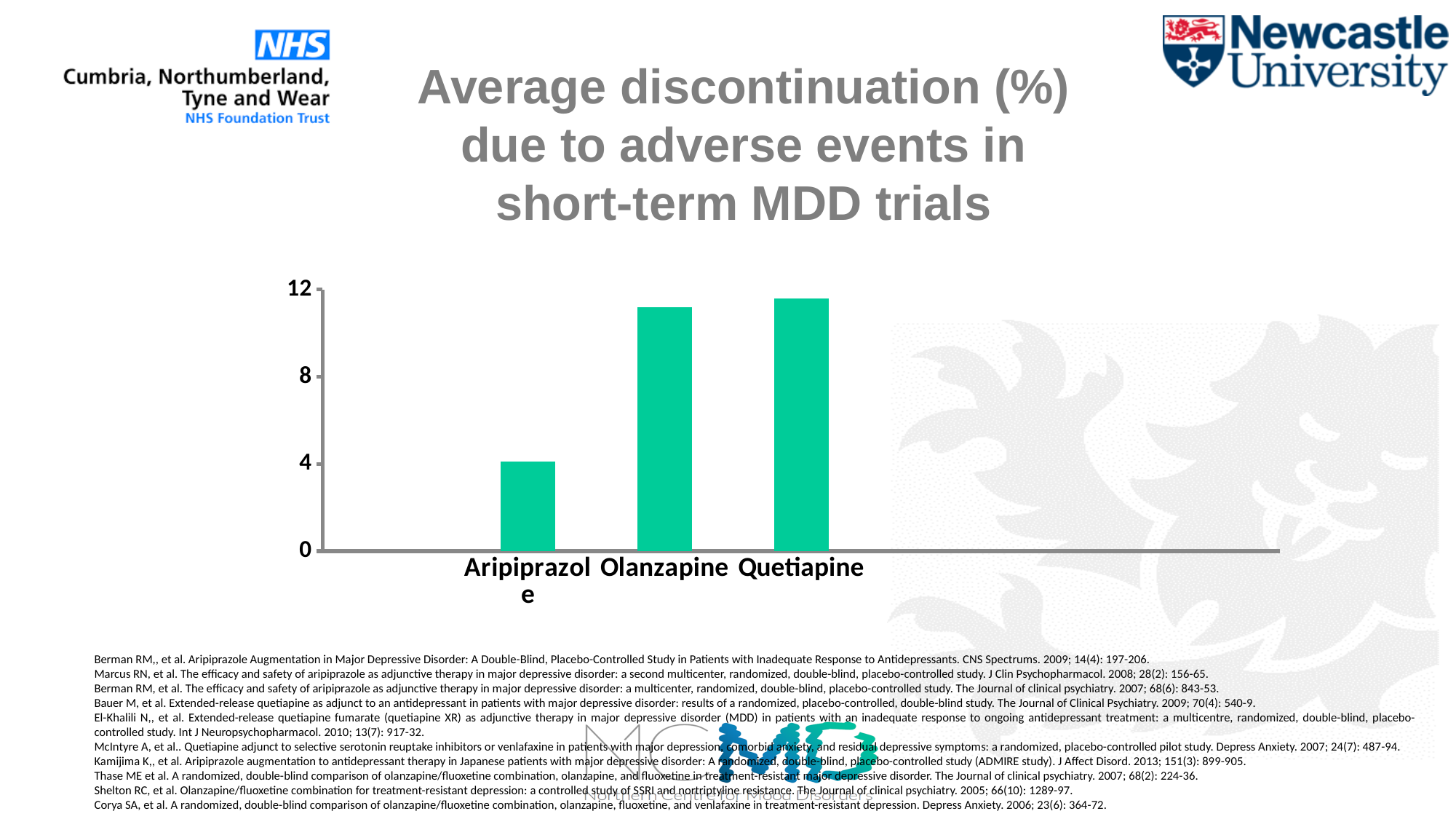
Is the value for Quetiapine greater or less than 8? greater Which has the larger value, Aripiprazole or Quetiapine? Quetiapine Which drug has the lowest average discontinuation due to adverse events? Aripiprazole What is the highest tick value shown on the vertical axis? 12 How many categories (drugs) are plotted in the chart? 3 Is the value for Aripiprazole greater or less than 8? less What kind of chart is shown on the slide? bar chart Is the value for Olanzapine greater or less than 8? greater What is the title of the chart on the slide? Average discontinuation (%) due to adverse events in short-term MDD trials Which has the larger value, Aripiprazole or Olanzapine? Olanzapine